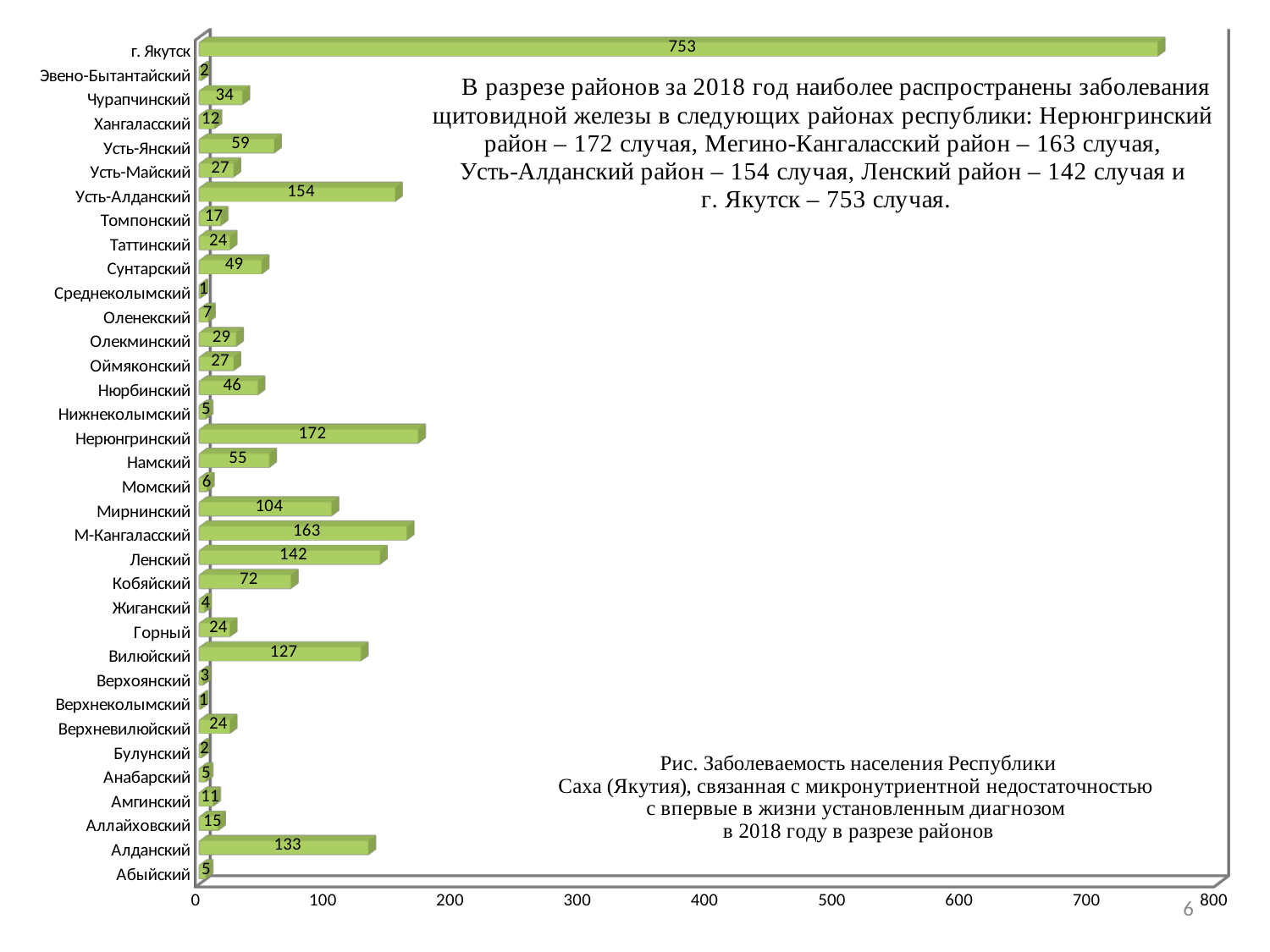
Which category has the highest value? г. Якутск How many categories are shown on the chart? 35 What is the value for Кобяйский? 72 What is the difference between the values for М-Кангаласский and Ленский? 21 What type of chart is shown on the slide? bar chart What is the highest value shown on the x axis? 800 Is the value for Усть-Алданский greater or less than 100? greater What is the value for Вилюйский? 127 What is the value for Алданский? 133 What is the difference between the values for г. Якутск and Нерюнгринский? 581 What is the value for Нерюнгринский? 172 Which is larger, the value for Мирнинский or the value for Вилюйский? Вилюйский